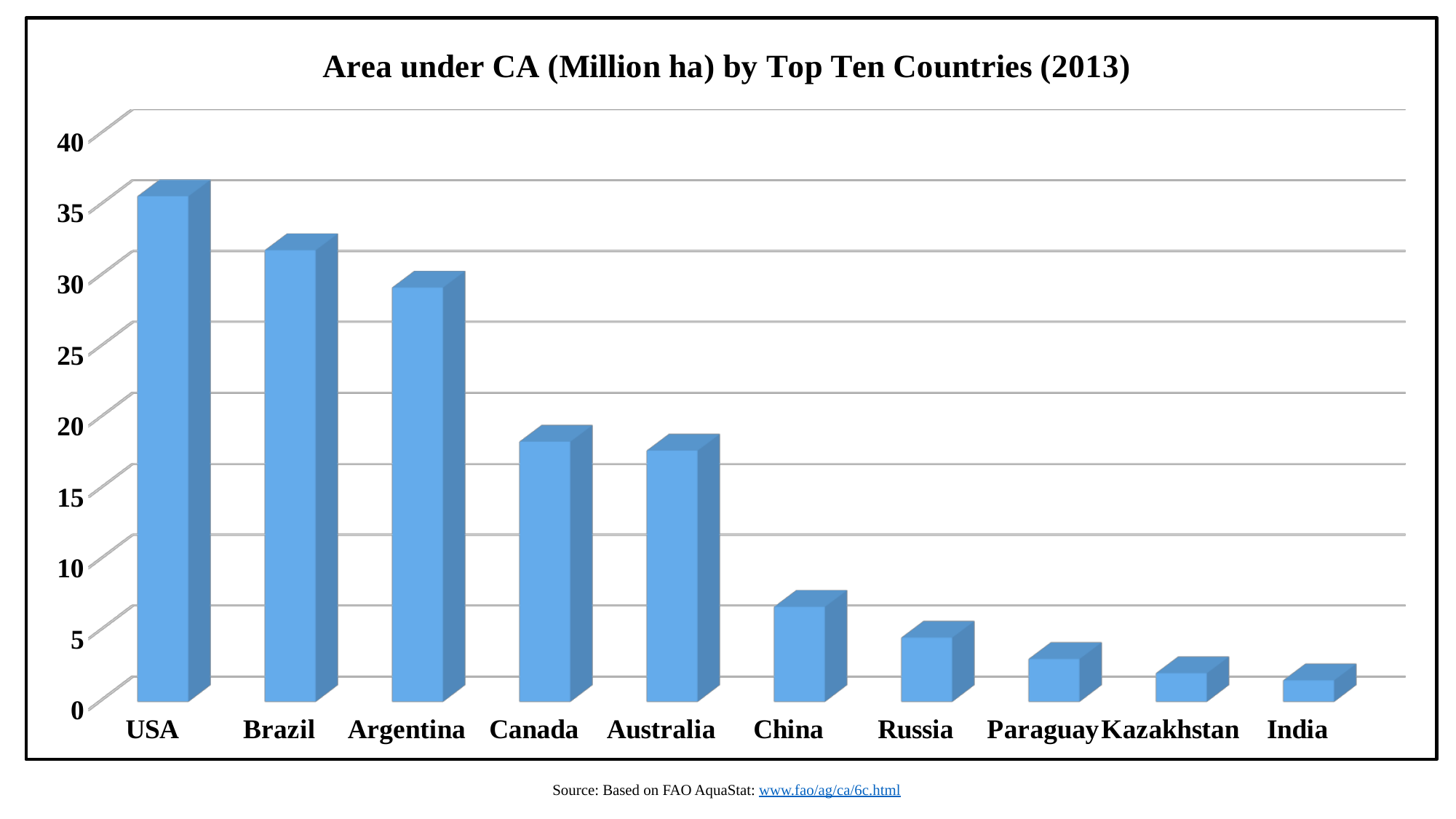
Is the value for Australia greater or less than 15? greater Is the value for USA greater or less than 30? greater How many countries are shown on the x axis of the chart? 10 Which country has the smallest area under CA in the chart? India What kind of chart is shown on the slide? bar chart Which country has the largest area under CA in the chart? USA Which has a larger area under CA, Argentina or Canada? Argentina What is the title of the chart? Area under CA (Million ha) by Top Ten Countries (2013) Is the value for Canada greater or less than 20? less Do the values rise or fall moving from left to right along the x axis? fall